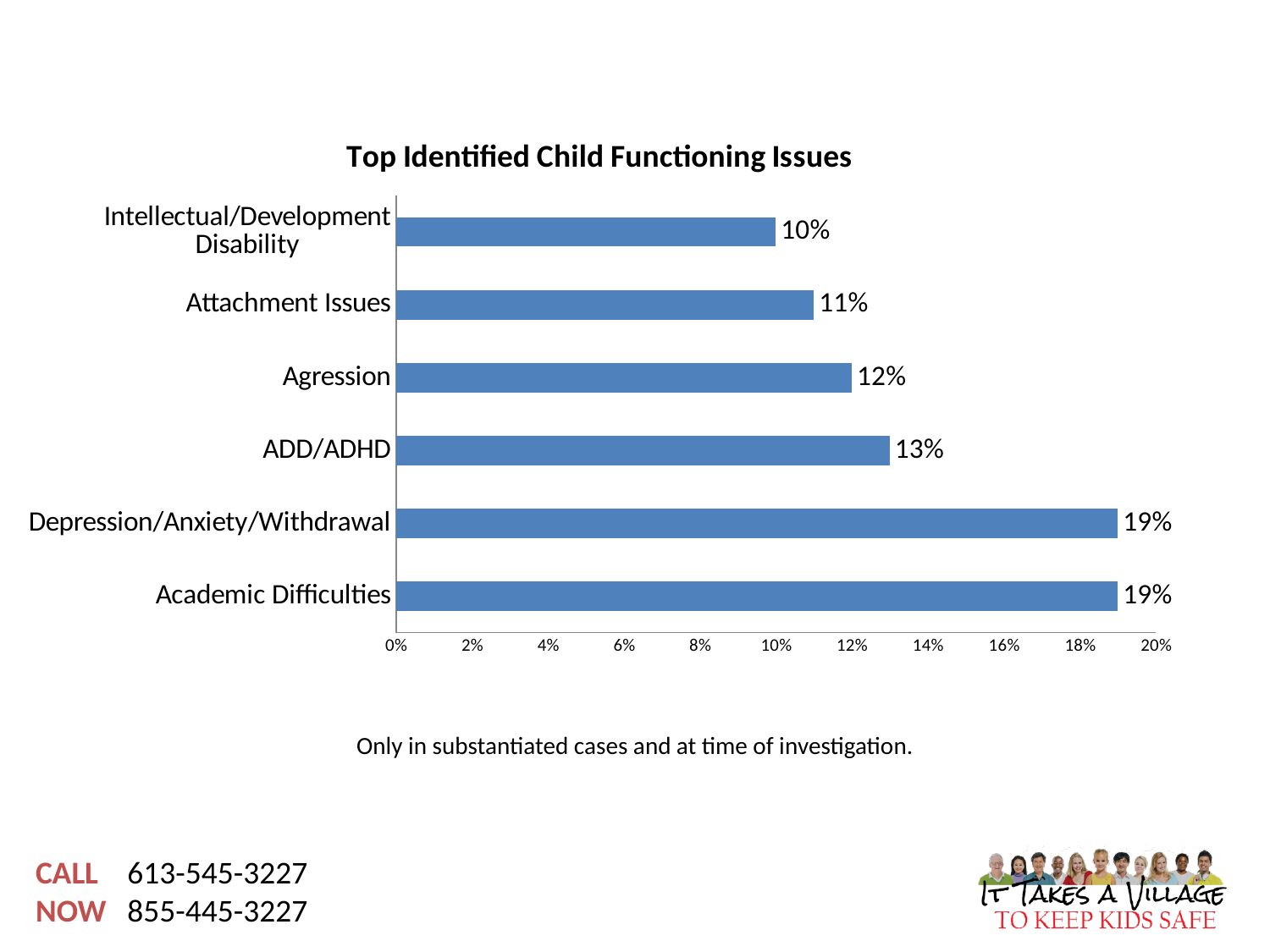
Which category has the lowest value? Intellectual/Development Disability Is the value for Academic Difficulties greater or less than 16%? greater What is the difference between the values for Agression and Intellectual/Development Disability? 2% What is the value for Intellectual/Development Disability? 10% What is the difference between the values for Academic Difficulties and ADD/ADHD? 6% What kind of chart is shown on the slide? Bar chart What is the value for ADD/ADHD? 13% What is the value for Agression? 12% What is the title of the chart? Top Identified Child Functioning Issues What is the value for Attachment Issues? 11% Which is larger, the value for Depression/Anxiety/Withdrawal or the value for Attachment Issues? Depression/Anxiety/Withdrawal How many categories are shown in the chart? 6